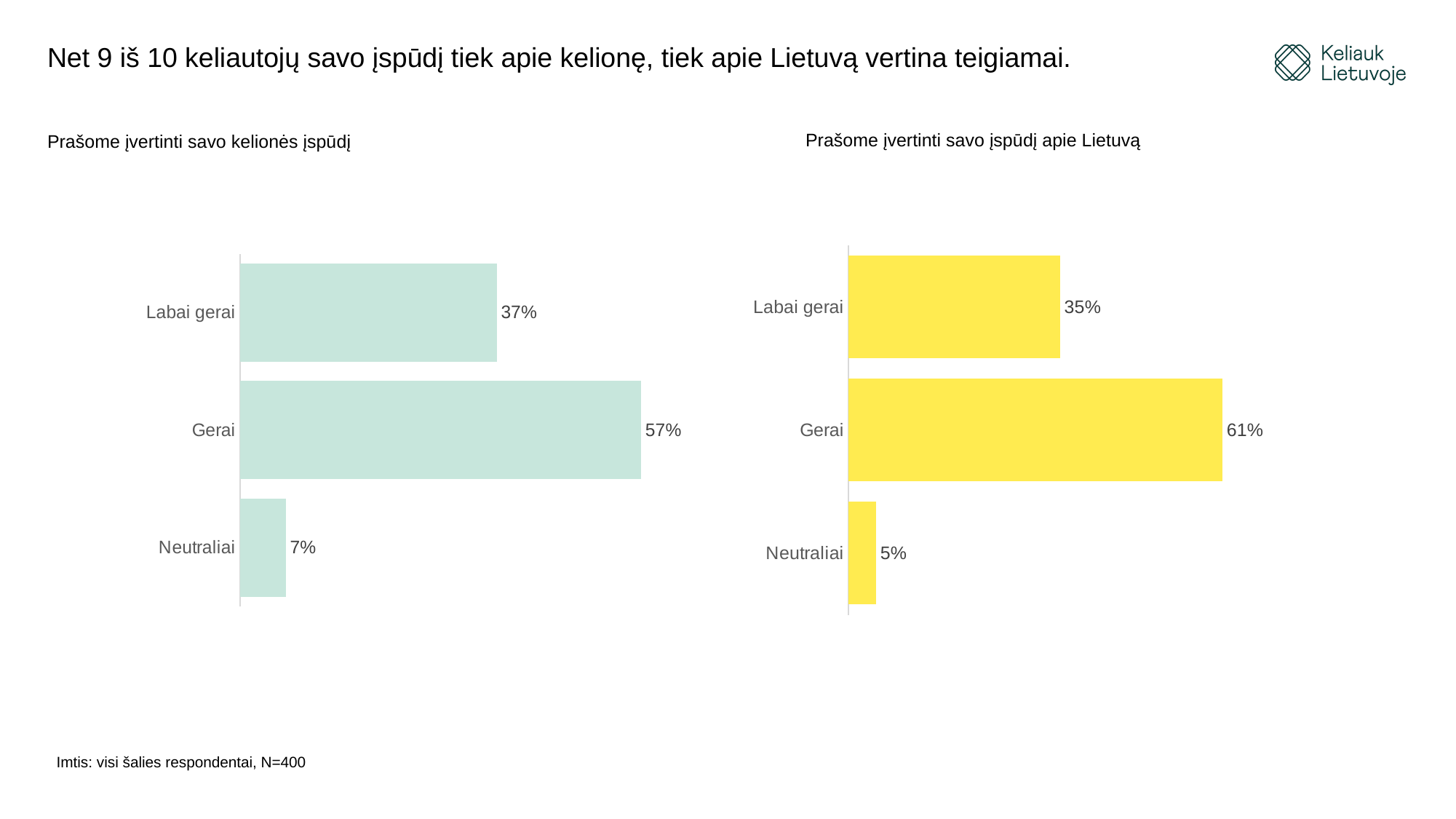
In the left chart (Prašome įvertinti savo kelionės įspūdį), what is the difference between Labai gerai and Neutraliai? 30% In the left chart (Prašome įvertinti savo kelionės įspūdį), which category has the lowest value? Neutraliai What colour are the bars in the right chart (Prašome įvertinti savo įspūdį apie Lietuvą)? Yellow How many categories does the right chart (Prašome įvertinti savo įspūdį apie Lietuvą) show? 3 Which is larger: Labai gerai in the left chart or Labai gerai in the right chart? Labai gerai in the left chart What type of chart is the left chart (Prašome įvertinti savo kelionės įspūdį)? Bar chart What is the title of the right chart? Prašome įvertinti savo įspūdį apie Lietuvą In the left chart (Prašome įvertinti savo kelionės įspūdį), what is the value for Gerai? 57% In the left chart (Prašome įvertinti savo kelionės įspūdį), what is the value for Neutraliai? 7% In the right chart (Prašome įvertinti savo įspūdį apie Lietuvą), what is the difference between Gerai and Labai gerai? 26% In the right chart (Prašome įvertinti savo įspūdį apie Lietuvą), which category has the highest value? Gerai In the right chart (Prašome įvertinti savo įspūdį apie Lietuvą), what is the value for Labai gerai? 35%